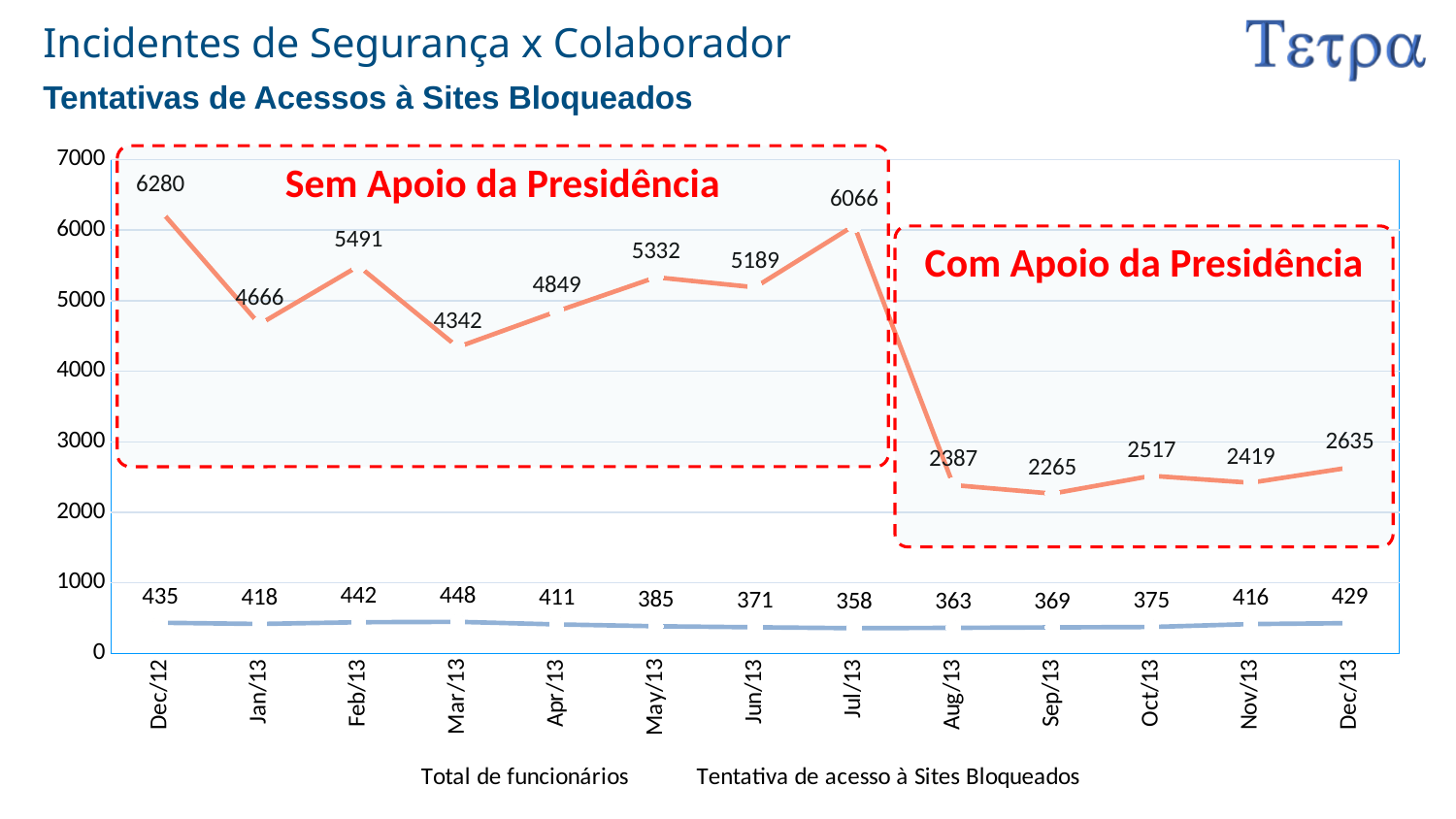
What is the value of Total de funcionários for Mar/13? 448 What is the difference between Tentativa de acesso à Sites Bloqueados in Jul/13 and Aug/13? 3679 What label is shown in the red dashed box covering Aug/13 to Dec/13? Com Apoio da Presidência What is the value of Tentativa de acesso à Sites Bloqueados for Jul/13? 6066 What type of chart is shown on the slide? line chart Which is larger, Tentativa de acesso à Sites Bloqueados in Feb/13 or in May/13? Feb/13 In which month is Tentativa de acesso à Sites Bloqueados lowest? Sep/13 How many months are plotted along the x axis? 13 In which month is Total de funcionários lowest? Jul/13 Is the value of Tentativa de acesso à Sites Bloqueados for Nov/13 greater or less than 3000? less In which month is Tentativa de acesso à Sites Bloqueados highest? Dec/12 How many series does the legend list? 2